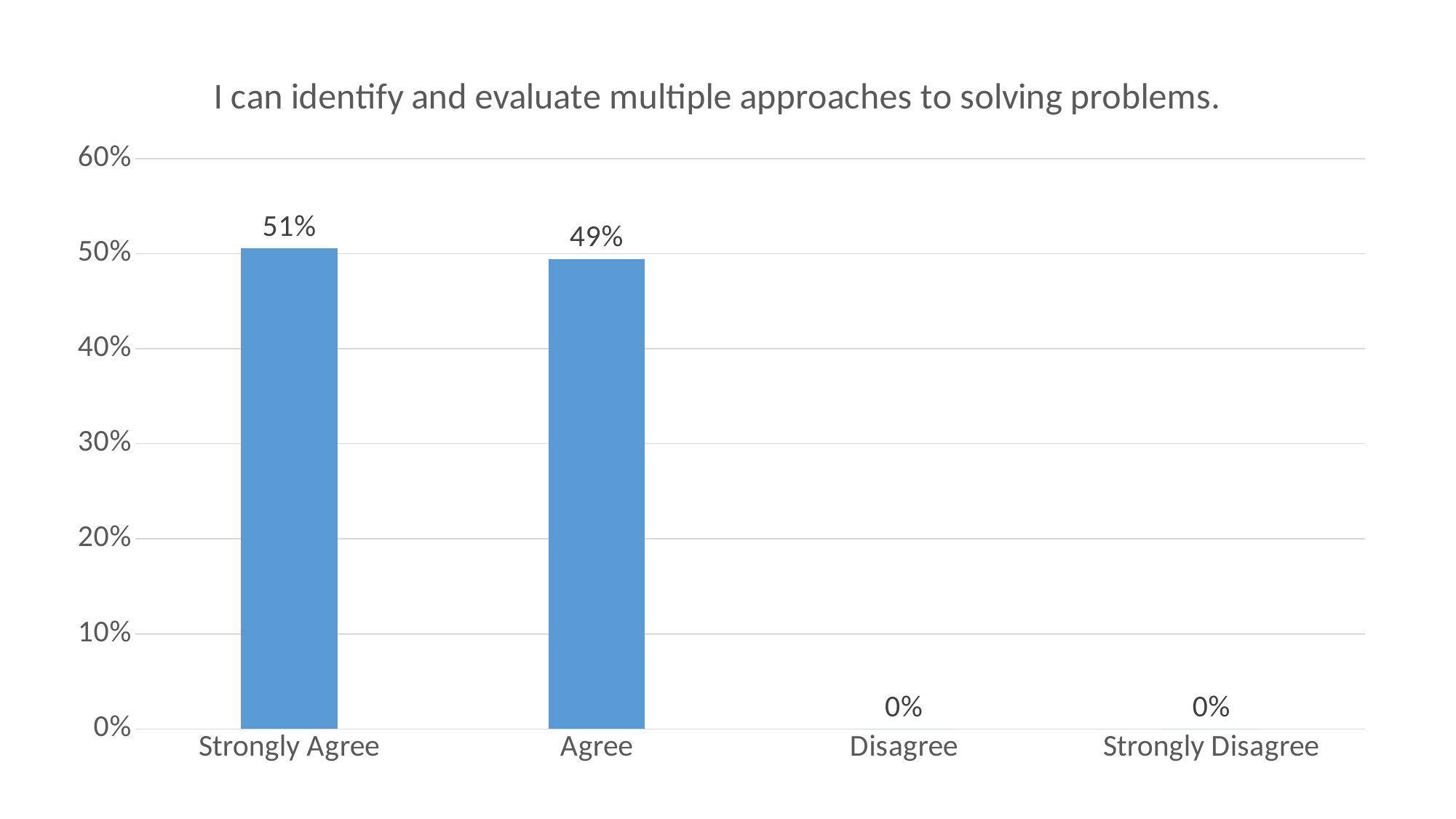
What is the title of the chart? I can identify and evaluate multiple approaches to solving problems. Which category has the highest value? Strongly Agree What is the value for Agree? 49% What is the value for Strongly Agree? 51% What is the value for Strongly Disagree? 0% What is the difference between the values for Strongly Agree and Agree? 2% Do the values rise or fall from Strongly Agree to Strongly Disagree along the x axis? fall What kind of chart is shown on the slide? bar chart How many categories are shown on the x axis? 4 What is the value for Disagree? 0% Is the value for Agree greater or less than 40%? greater Which is larger, the value for Strongly Agree or the value for Agree? Strongly Agree